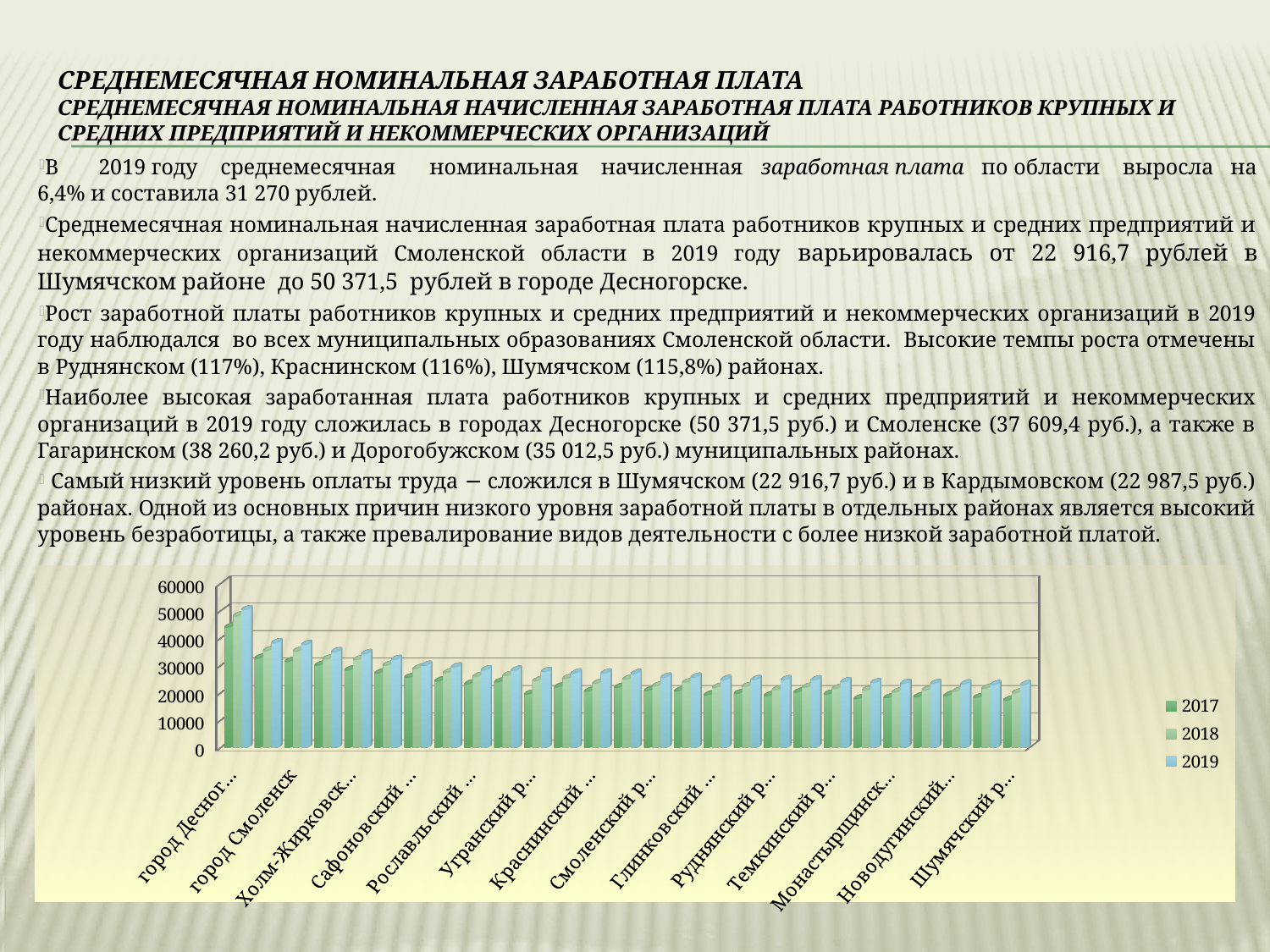
Which has the larger 2019 value, город Десногорск or город Смоленск? город Десногорск Is the 2019 value for город Десногорск greater or less than 40000? greater Is the 2017 value for город Десногорск greater or less than 40000? greater How many series does the chart legend list? 3 Which category has the highest bars in the chart? город Десногорск Do the values generally rise or fall moving from left to right along the x axis? fall What kind of chart is shown on the slide? bar chart For город Десногорск, which is larger, the 2017 value or the 2019 value? 2019 Which years are listed in the chart legend? 2017, 2018, 2019 Is the 2019 value for город Смоленск greater or less than 30000? greater